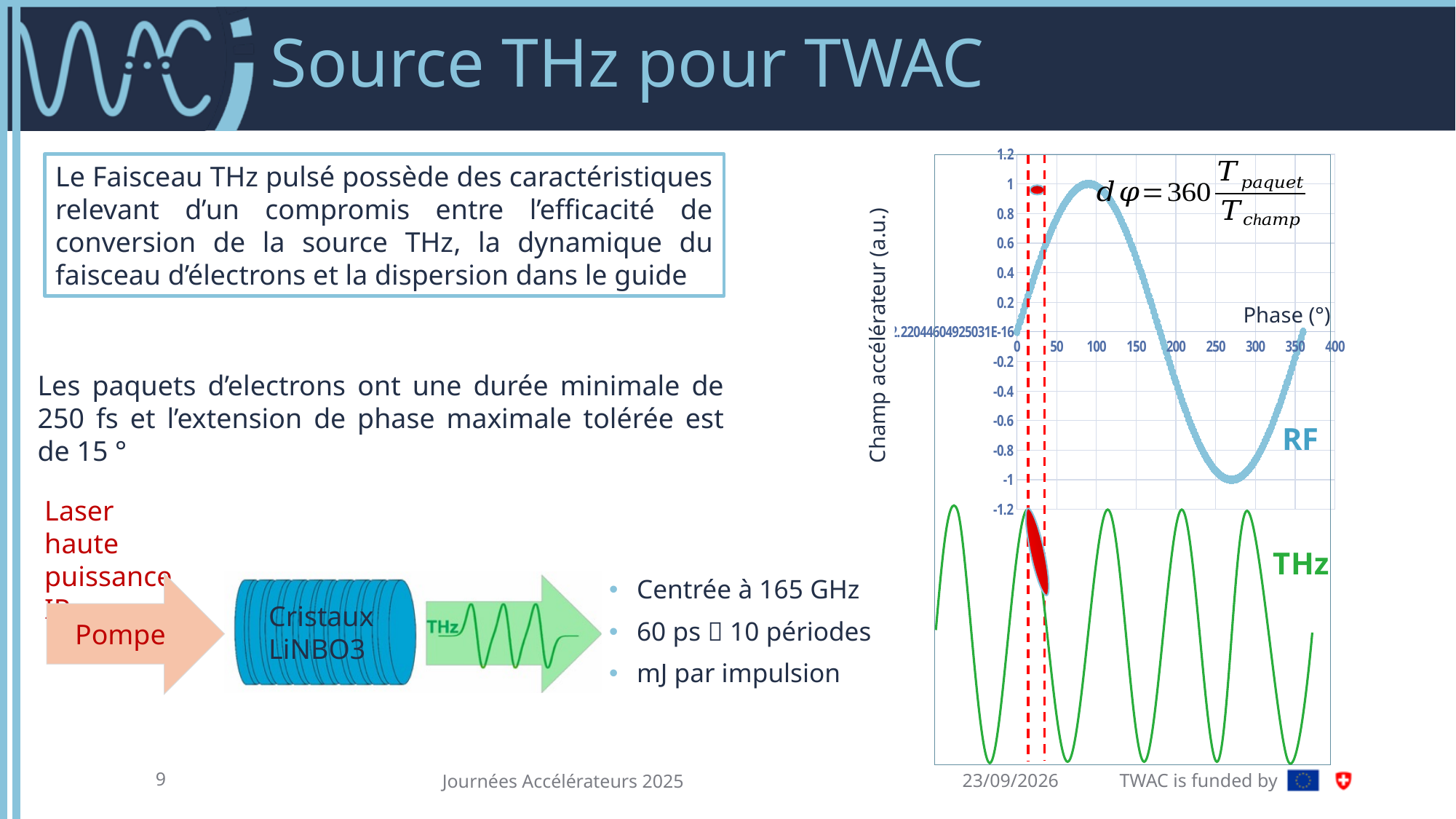
What is the highest value reached by the RF curve on the chart? 1 Does the RF curve rise or fall as the phase goes from 0° to 90°? rise Is the value of the RF curve at a phase of 100° greater or less than 0.8? greater Does the RF curve rise or fall as the phase goes from 100° to 250°? fall What is the label of the horizontal axis of the chart? Phase (°) Is the value of the RF curve at a phase of 200° greater or less than 0? less What is the largest phase value labelled on the horizontal axis of the chart? 400 How many tick labels are shown on the horizontal axis of the chart, from 0 to 400? 9 What kind of chart is shown on the right of the slide? line chart What is the label of the vertical axis of the chart? Champ accélérateur (a.u.) Is the value of the RF curve at a phase of 250° greater or less than -0.8? less What is the lowest value reached by the RF curve on the chart? -1